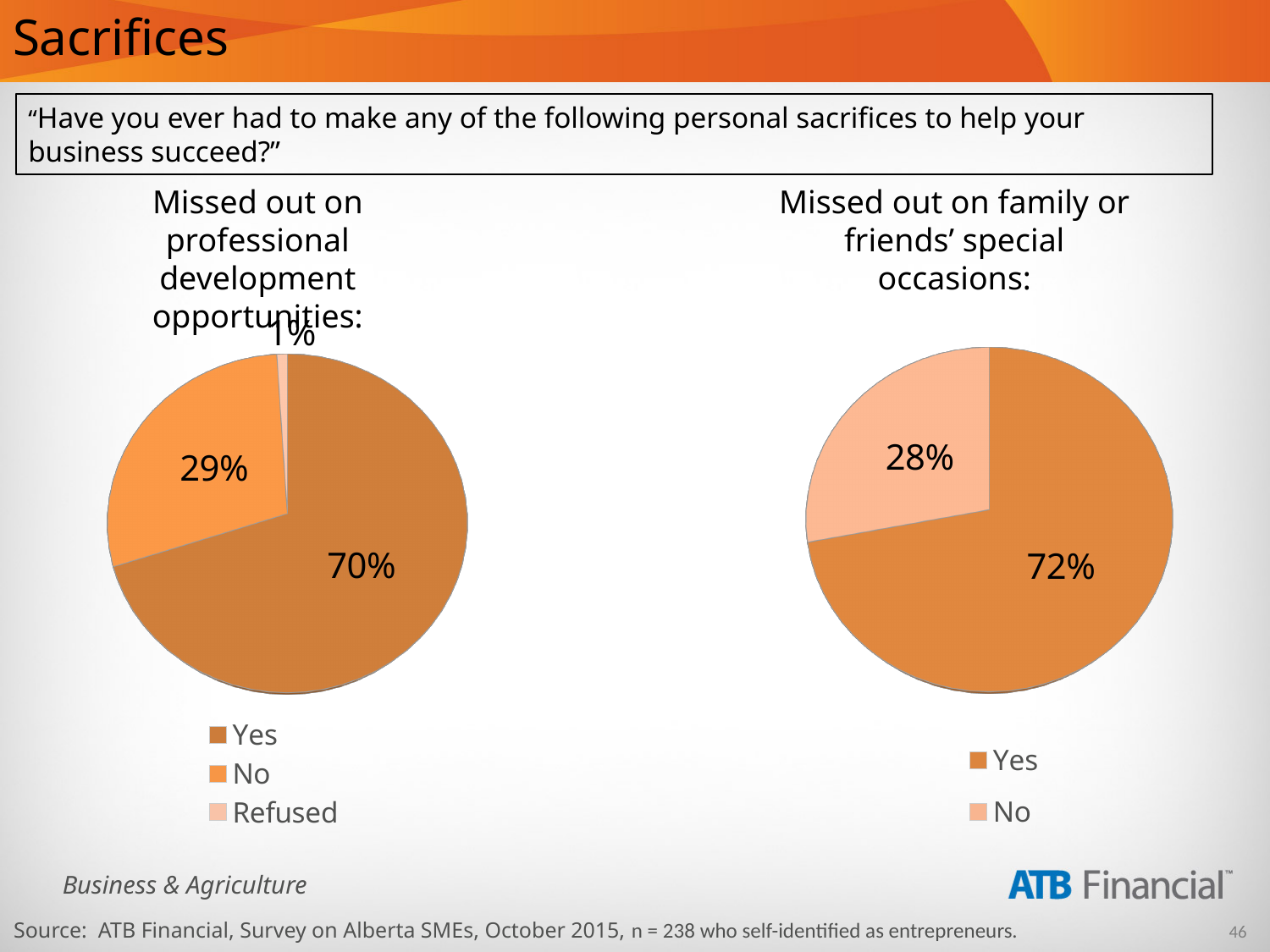
In the 'Missed out on professional development opportunities' pie chart, what percentage answered Yes? 70% In the 'Missed out on family or friends' special occasions' pie chart, what percentage answered No? 28% What type of chart is used for 'Missed out on family or friends' special occasions'? Pie chart How many slices does the 'Missed out on professional development opportunities' pie chart have? 3 How many entries does the legend of the 'Missed out on family or friends' special occasions' chart list? 2 In the 'Missed out on professional development opportunities' pie chart, what percentage is shown for Refused? 1% In the 'Missed out on family or friends' special occasions' pie chart, what is the difference between the Yes and No shares? 44% In the 'Missed out on professional development opportunities' pie chart, what percentage answered No? 29% In the 'Missed out on professional development opportunities' pie chart, which response has the largest share? Yes Which chart has the larger Yes share: 'Missed out on professional development opportunities' or 'Missed out on family or friends' special occasions'? Missed out on family or friends' special occasions In the 'Missed out on family or friends' special occasions' pie chart, what percentage answered Yes? 72% In the 'Missed out on professional development opportunities' pie chart, which response has the smallest share? Refused